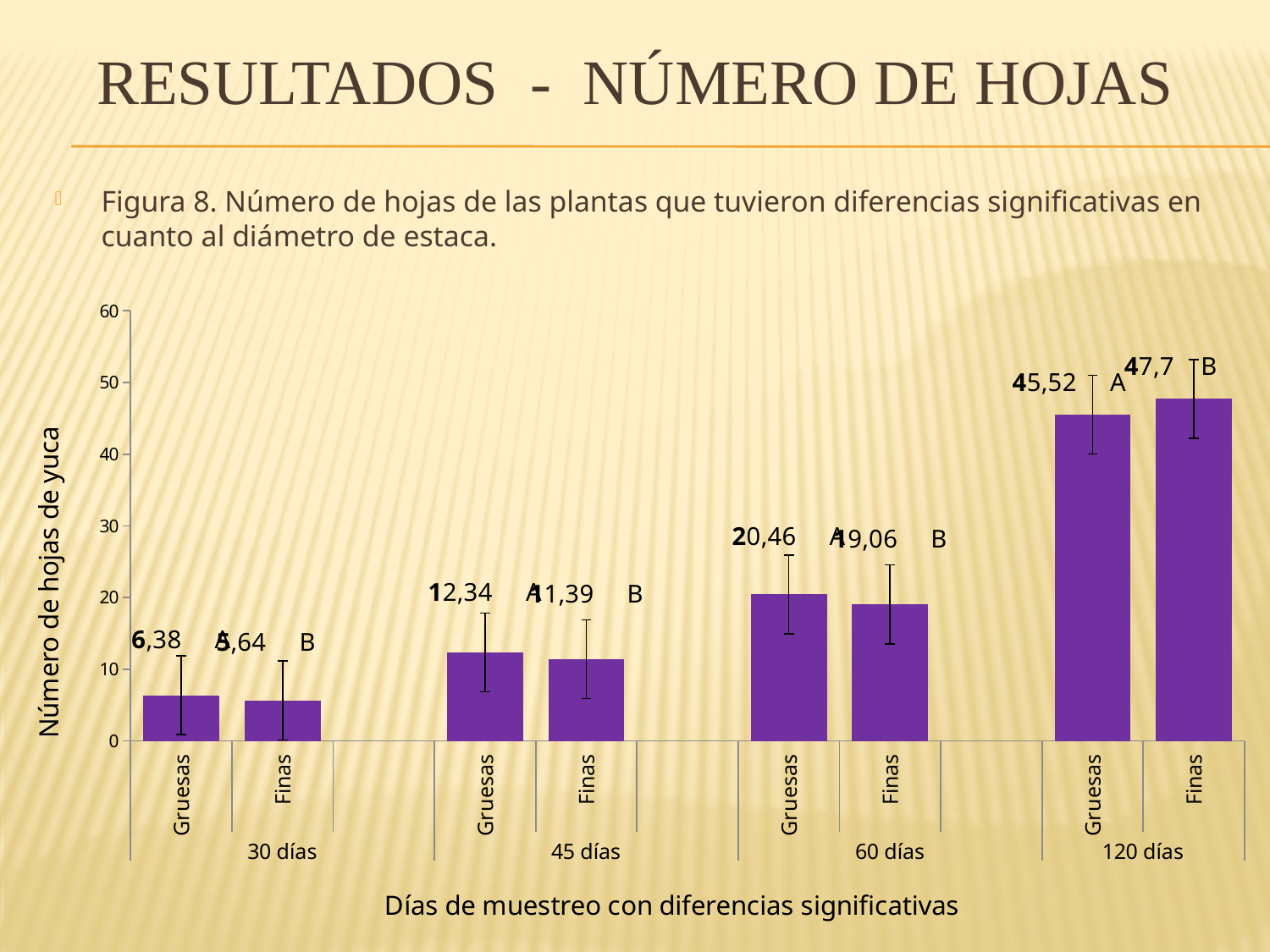
What is the value for Gruesas at 60 días? 20,46 What is the label of the vertical axis? Número de hojas de yuca What is the difference between Gruesas and Finas at 60 días? 1,4 Which bar has the highest value? Finas at 120 días What is the value for Gruesas at 30 días? 6,38 How many bars are plotted in the chart? 8 Which bar has the lowest value? Finas at 30 días What is the value for Finas at 45 días? 11,39 Which is larger at 45 días, Gruesas or Finas? Gruesas What is the value for Finas at 120 días? 47,7 What type of chart is shown on the slide? bar chart Do the values for Gruesas rise or fall from 30 días to 120 días? rise